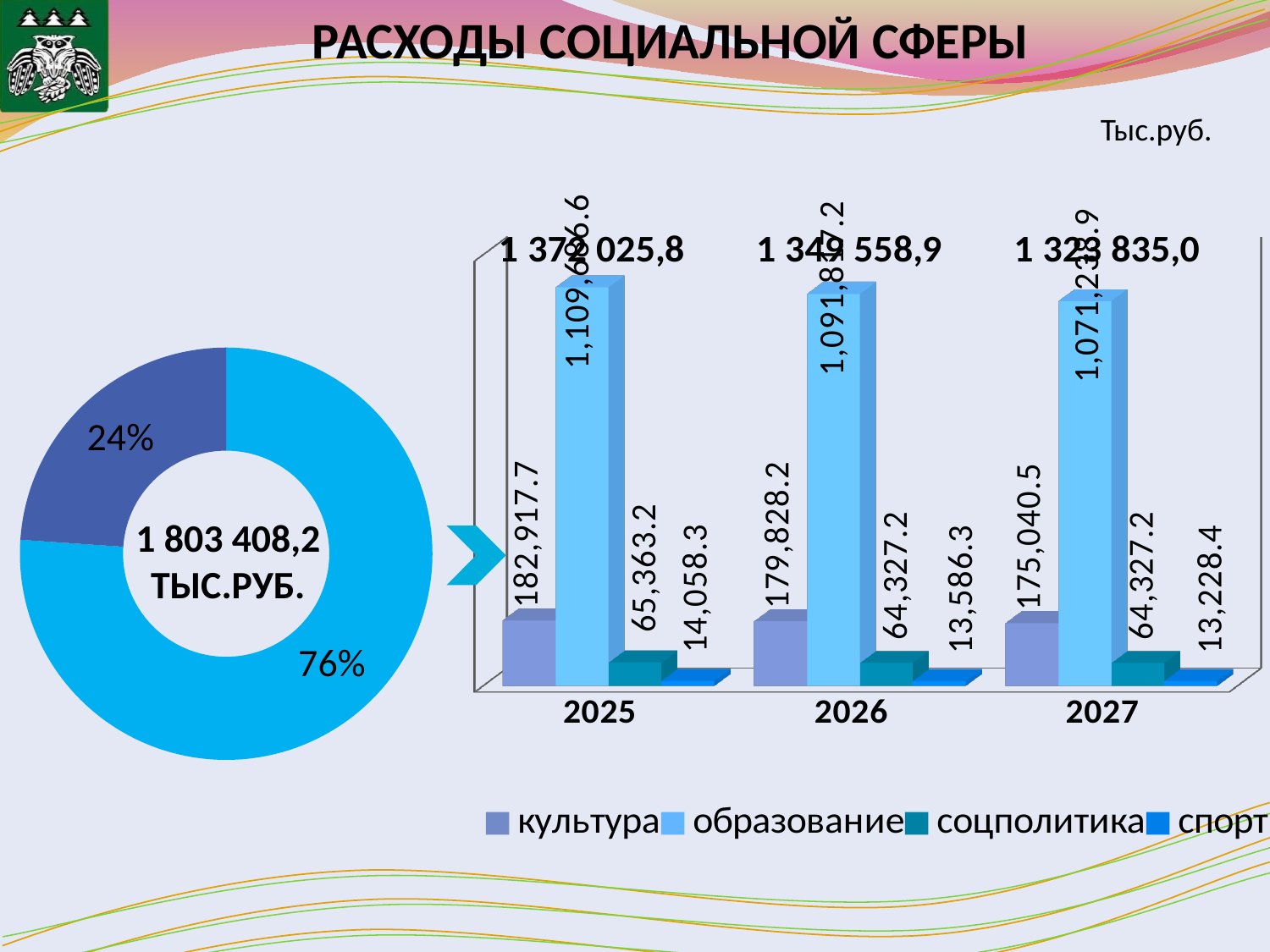
In the bar chart on the right, what is the value for спорт in 2027? 13,228.4 In the donut chart on the left, what share does the larger slice have? 76% In the bar chart on the right, what is the value for культура in 2025? 182,917.7 What total is printed in the centre of the donut chart on the left? 1 803 408,2 ТЫС.РУБ. In the bar chart on the right, how many series does the legend list? 4 In the bar chart on the right, in which year is the value for культура highest? 2025 In the bar chart on the right, which is larger: спорт in 2025 or спорт in 2026? 2025 In the bar chart on the right, what total is printed above the bars for 2025? 1 372 025,8 In the bar chart on the right, how many years are shown on the x axis? 3 In the bar chart on the right, what is the difference between the культура values for 2025 and 2027? 7,877.2 In the bar chart on the right, do the values for спорт rise or fall from 2025 to 2027? fall In the bar chart on the right, what is the value for соцполитика in 2026? 64,327.2